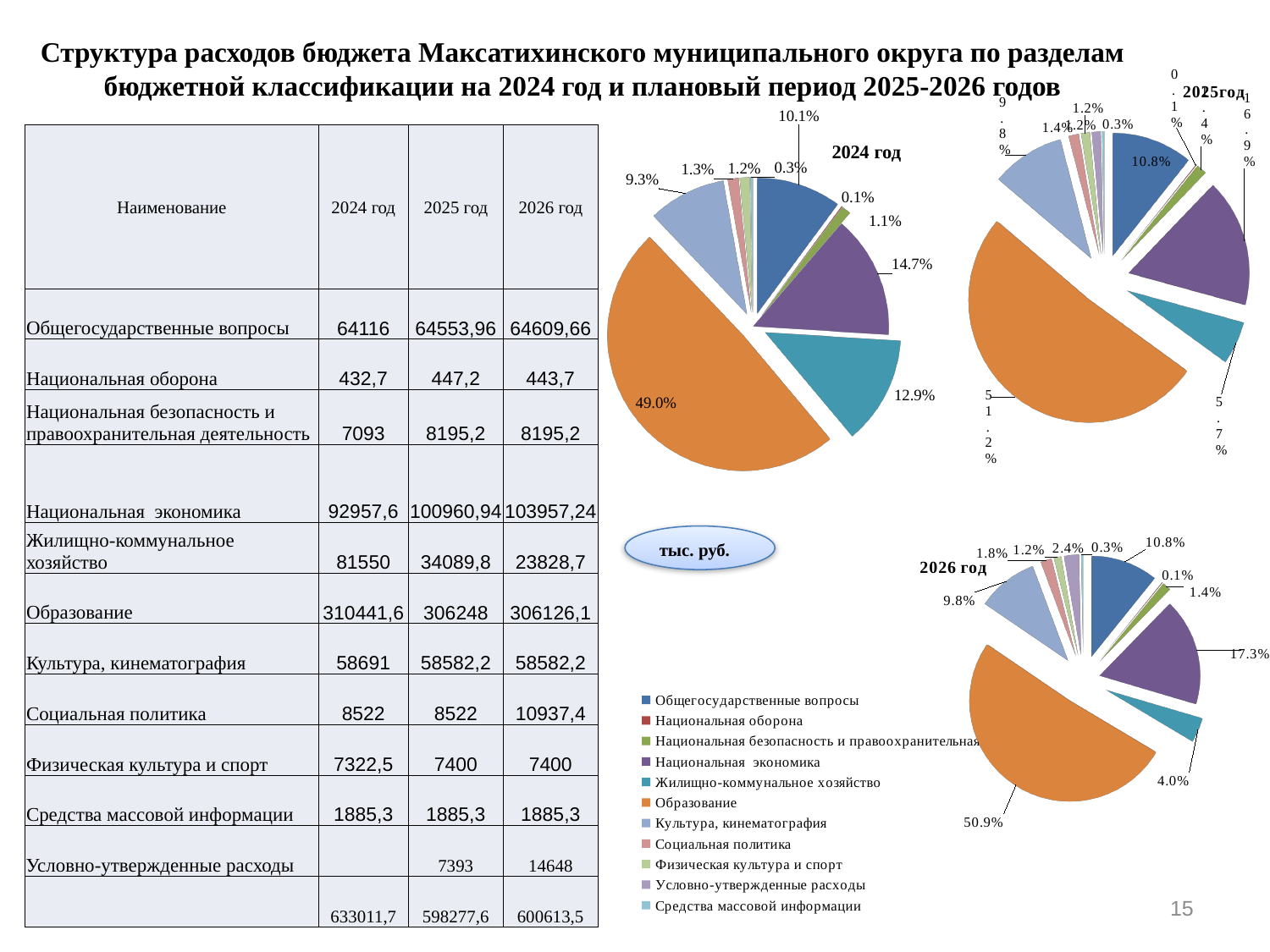
In the 2026 год pie chart, what share does Жилищно-коммунальное хозяйство have? 4.0% Which is larger: the share of Жилищно-коммунальное хозяйство in the 2024 год pie chart or in the 2026 год pie chart? 2024 год In the 2024 год pie chart, which category has the smallest share? Национальная оборона In the 2026 год pie chart, what share does Национальная экономика have? 17.3% In the 2024 год pie chart, what share does Образование have? 49.0% How many categories does the legend list for the pie charts? 11 How many pie charts are shown on the slide? 3 In the 2026 год pie chart, what share does Образование have? 50.9% In the 2024 год pie chart, what is the difference in percentage points between Национальная экономика (14.7%) and Общегосударственные вопросы (10.1%)? 4.6 In the 2024 год pie chart, what share does Жилищно-коммунальное хозяйство have? 12.9% In the 2024 год pie chart, which category has the largest share? Образование What kind of chart is used to show the 2024 год budget structure? pie chart